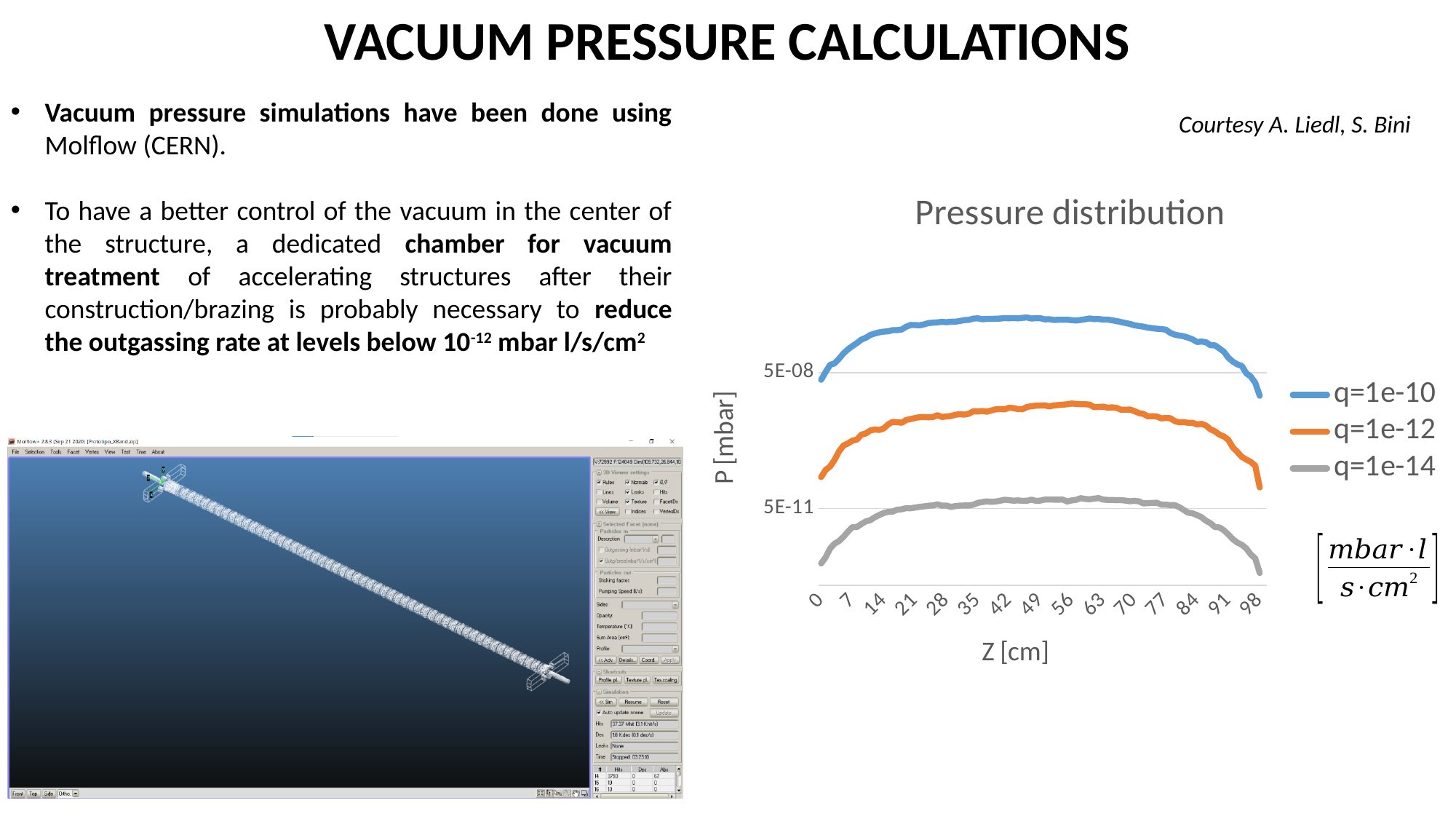
What is the title of the chart on the right of the slide? Pressure distribution In the 'Pressure distribution' chart, which series is larger at Z = 49 cm: q=1e-10 or q=1e-14? q=1e-10 In the 'Pressure distribution' chart, does the q=1e-12 series rise or fall between Z = 0 cm and Z = 49 cm? rise In the 'Pressure distribution' chart, is the value of the q=1e-10 series at Z = 49 cm greater or less than 5E-08? greater What kind of chart is the 'Pressure distribution' chart? line chart What is the label of the vertical axis of the 'Pressure distribution' chart? P [mbar] In the 'Pressure distribution' chart, which series has the highest pressure values? q=1e-10 In the 'Pressure distribution' chart, is the value of the q=1e-12 series at Z = 49 cm greater or less than 5E-08? less How many series does the legend of the 'Pressure distribution' chart list? 3 How many tick labels are shown on the Z [cm] axis of the 'Pressure distribution' chart? 15 In the 'Pressure distribution' chart, is the value of the q=1e-14 series at Z = 0 cm greater or less than 5E-11? less In the 'Pressure distribution' chart, which series has the lowest pressure values? q=1e-14